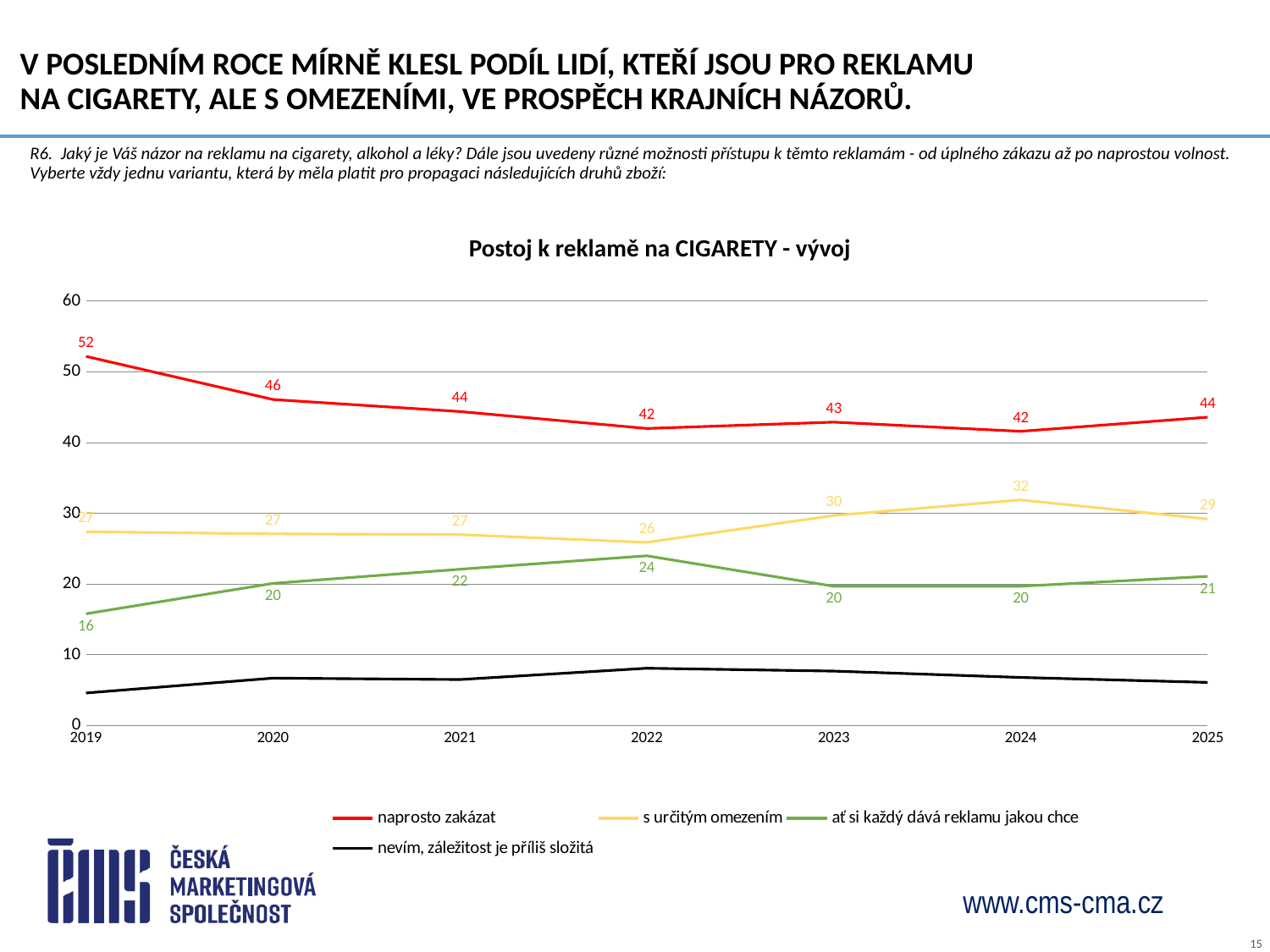
In which year is the "naprosto zakázat" series at its highest? 2019 Which is larger in 2025: the value for "s určitým omezením" or for "ať si každý dává reklamu jakou chce"? s určitým omezením What is the value for "naprosto zakázat" in 2019? 52 How many years are shown on the x axis? 7 What is the title of the chart? Postoj k reklamě na CIGARETY - vývoj In which year is the "ať si každý dává reklamu jakou chce" series at its lowest? 2019 Is the value for "nevím, záležitost je příliš složitá" in 2022 greater or less than 10? less What type of chart is shown on the slide? line chart What is the value for "ať si každý dává reklamu jakou chce" in 2022? 24 What is the difference between the "naprosto zakázat" value in 2019 and in 2025? 8 How many series does the legend list? 4 What is the value for "s určitým omezením" in 2024? 32